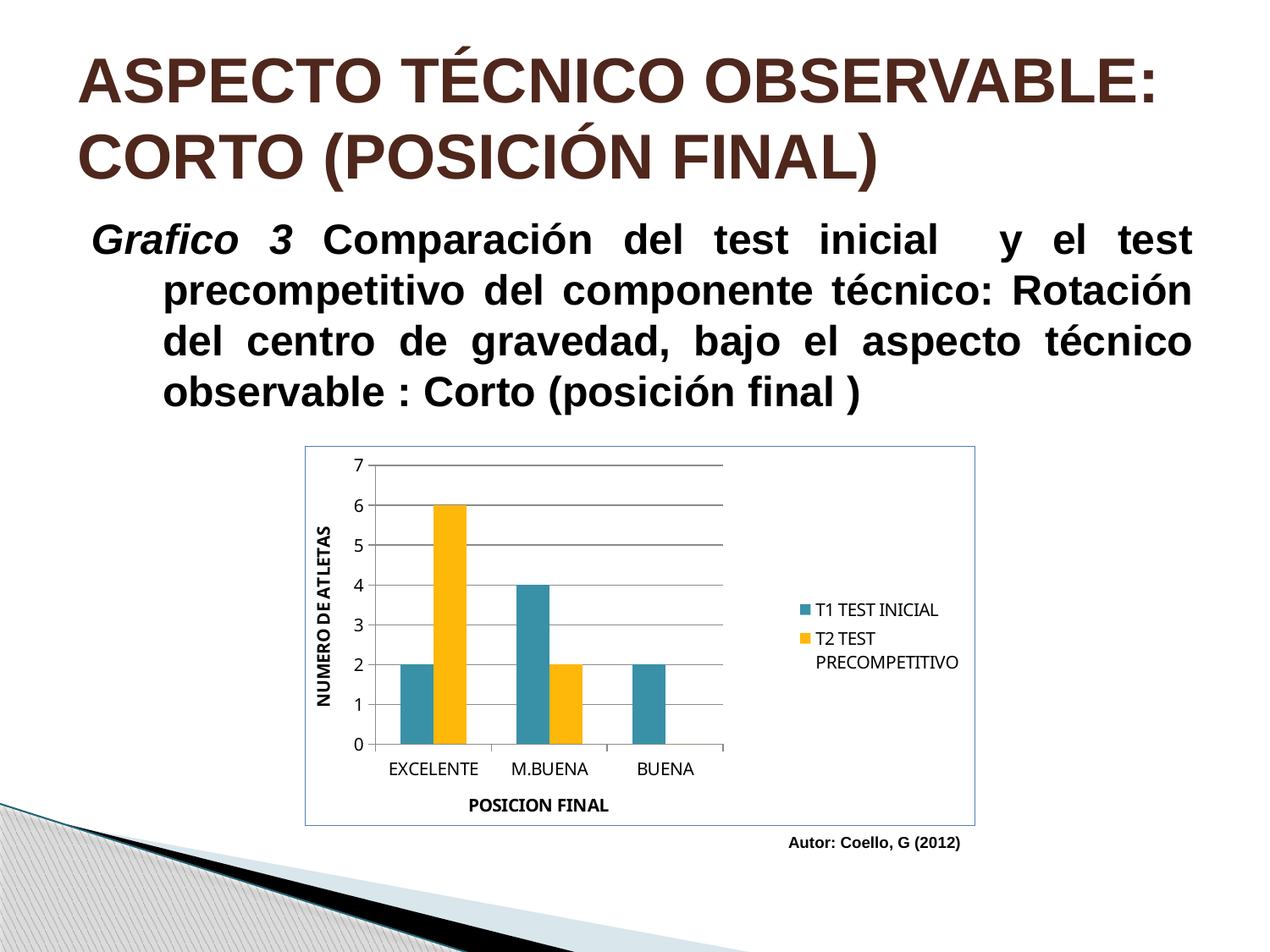
Which category has the highest value in the T2 TEST PRECOMPETITIVO series? EXCELENTE How many categories are shown on the x axis? 3 What kind of chart is shown on the slide? bar chart For M.BUENA, which series has the larger value, T1 TEST INICIAL or T2 TEST PRECOMPETITIVO? T1 TEST INICIAL What is the value for BUENA in the T1 TEST INICIAL series? 2 What is the difference between the T2 TEST PRECOMPETITIVO and T1 TEST INICIAL values for EXCELENTE? 4 What is the value for M.BUENA in the T1 TEST INICIAL series? 4 What is the value for EXCELENTE in the T2 TEST PRECOMPETITIVO series? 6 Which category has the highest value in the T1 TEST INICIAL series? M.BUENA What is the value for EXCELENTE in the T1 TEST INICIAL series? 2 How many series does the legend list? 2 What is the label of the y axis? NUMERO DE ATLETAS